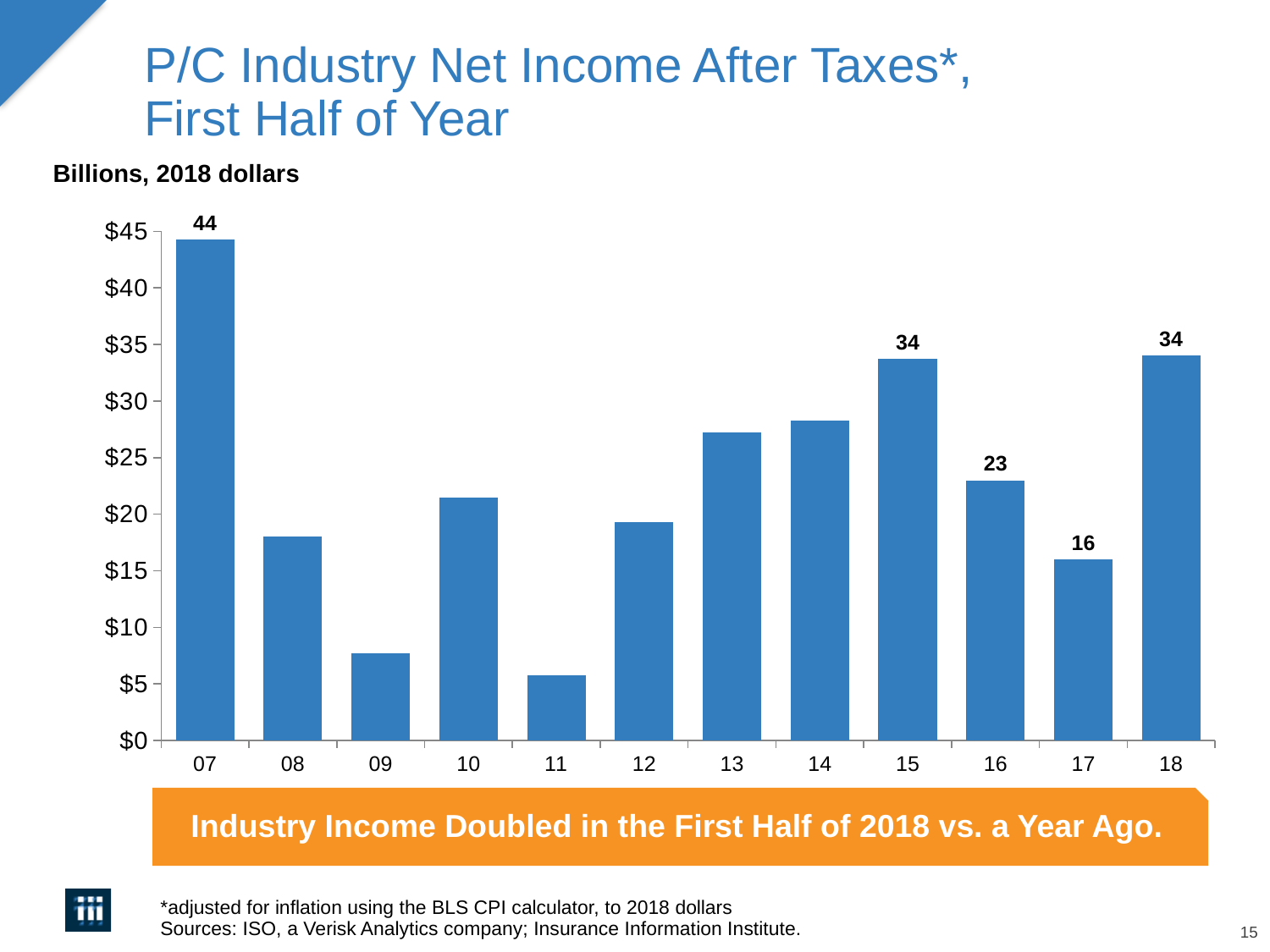
Is the value for 11 greater or less than $10? less Which year has the lowest value? 11 How many years are shown on the x axis? 12 What unit is stated above the chart? Billions, 2018 dollars What kind of chart is shown? bar chart What is the difference between the values for 18 and 17? 18 Is the value for 13 greater or less than $25? greater What is the value for 17? 16 Which year has the highest value? 07 What is the value for 16? 23 Which is larger, the value for 16 or the value for 17? 16 What is the value for 07? 44